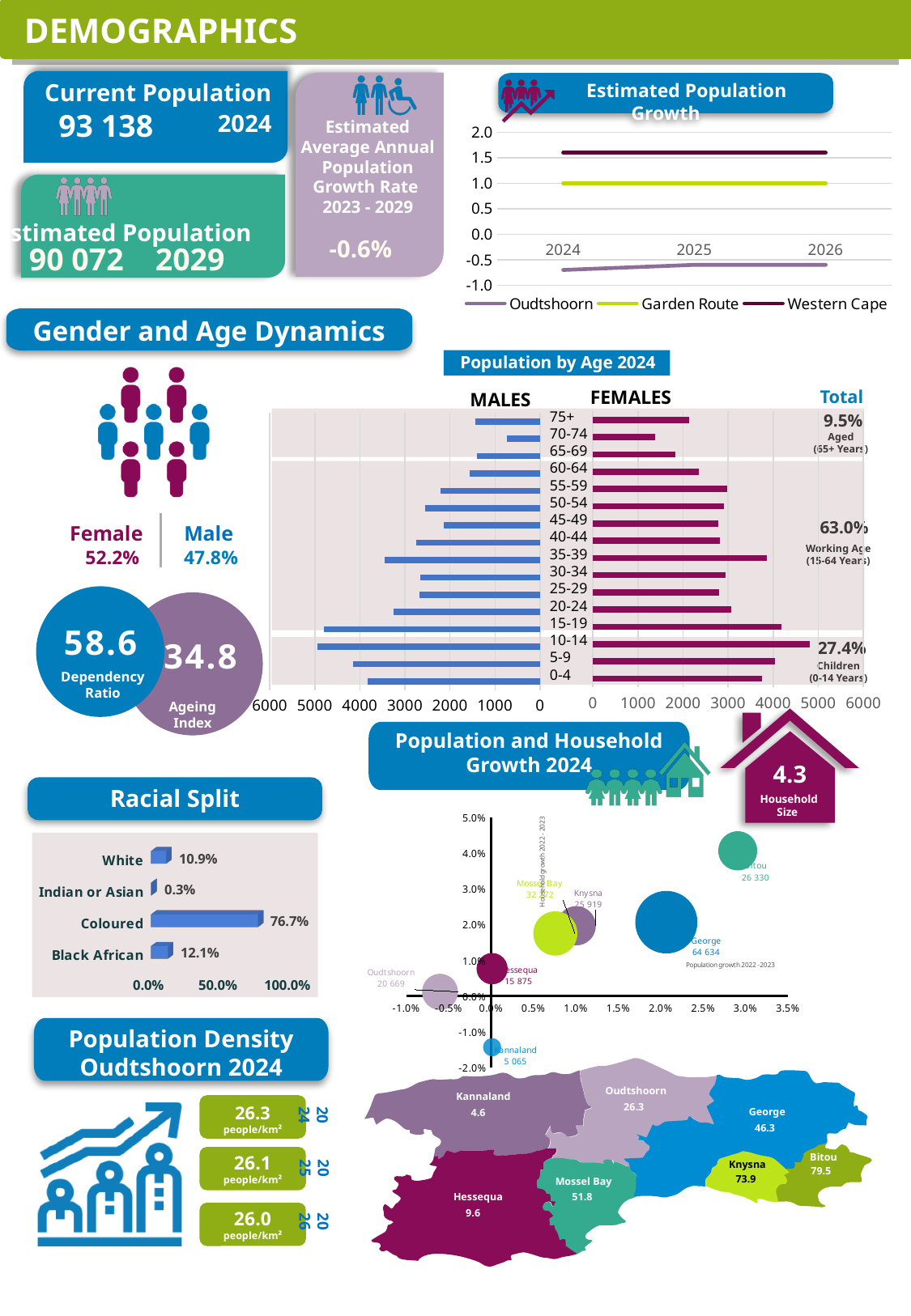
In the Population and Household Growth 2024 bubble chart, what population value is labelled for George? 64 634 How many categories are shown in the Racial Split chart? 4 In the Racial Split chart, what is the difference between the Black African and White percentages? 1.2% In the Racial Split chart, what percentage is shown for Indian or Asian? 0.3% In the Estimated Population Growth chart, is the value for Western Cape in 2025 greater or less than 1.0? greater How many series does the legend of the Estimated Population Growth chart list? 3 What kind of chart is the Population by Age 2024 chart? Bar chart In the Estimated Population Growth chart, is the value for Oudtshoorn in 2024 greater or less than 0.0? less In the Racial Split chart, what percentage is shown for Coloured? 76.7% In the Racial Split chart, which category has the highest value? Coloured In the Estimated Population Growth chart, which series has the lowest values? Oudtshoorn In the Racial Split chart, which category has the lowest value? Indian or Asian